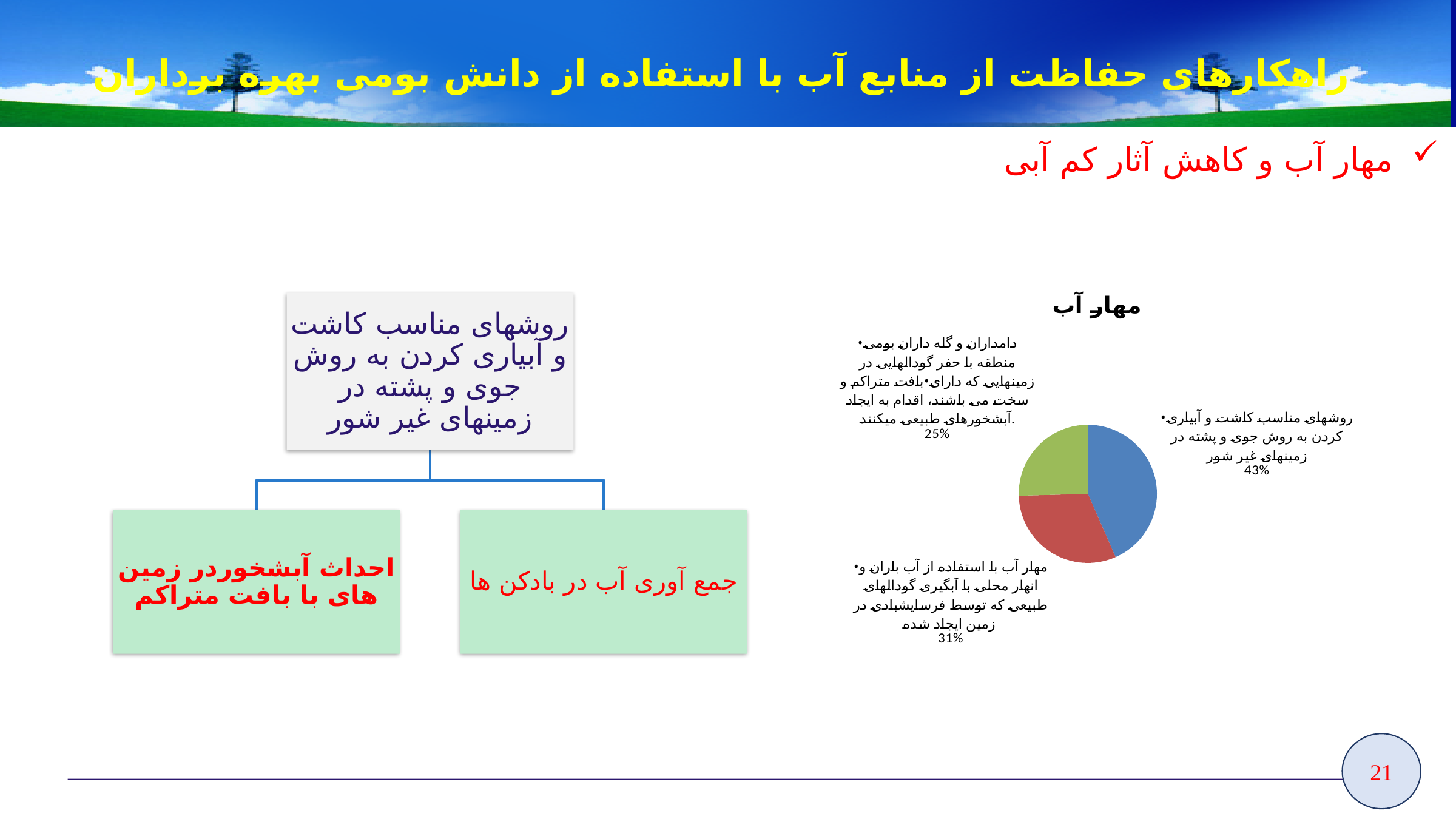
In the pie chart "مهار آب", what colour is the slice labelled 43%? blue In the pie chart "مهار آب", what share is labelled for the slice about "دامداران و گله داران بومی منطقه" creating natural watering holes? 25% In the pie chart "مهار آب", what share is labelled for the slice "روشهای مناسب کاشت و آبیاری کردن به روش جوی و پشته در زمینهای غیر شور"? 43% In the pie chart "مهار آب", what share is labelled for the slice about "مهار آب با استفاده از آب باران و انهار محلی"? 31% In the pie chart "مهار آب", which slice has the smallest share? دامداران و گله داران بومی منطقه (آبشخورهای طبیعی) What is the title of the pie chart on the slide? مهار آب How many slices does the pie chart "مهار آب" have? 3 In the pie chart "مهار آب", which slice has the largest share? روشهای مناسب کاشت و آبیاری کردن به روش جوی و پشته در زمینهای غیر شور What kind of chart is shown under the title "مهار آب"? pie chart In the pie chart "مهار آب", what is the difference in percentage points between the 31% slice and the 25% slice? 6 In the pie chart "مهار آب", which is larger: the share for "مهار آب با استفاده از آب باران و انهار محلی" or the share for "دامداران و گله داران بومی منطقه"? مهار آب با استفاده از آب باران و انهار محلی In the pie chart "مهار آب", what is the difference in percentage points between the 43% slice and the 31% slice? 12